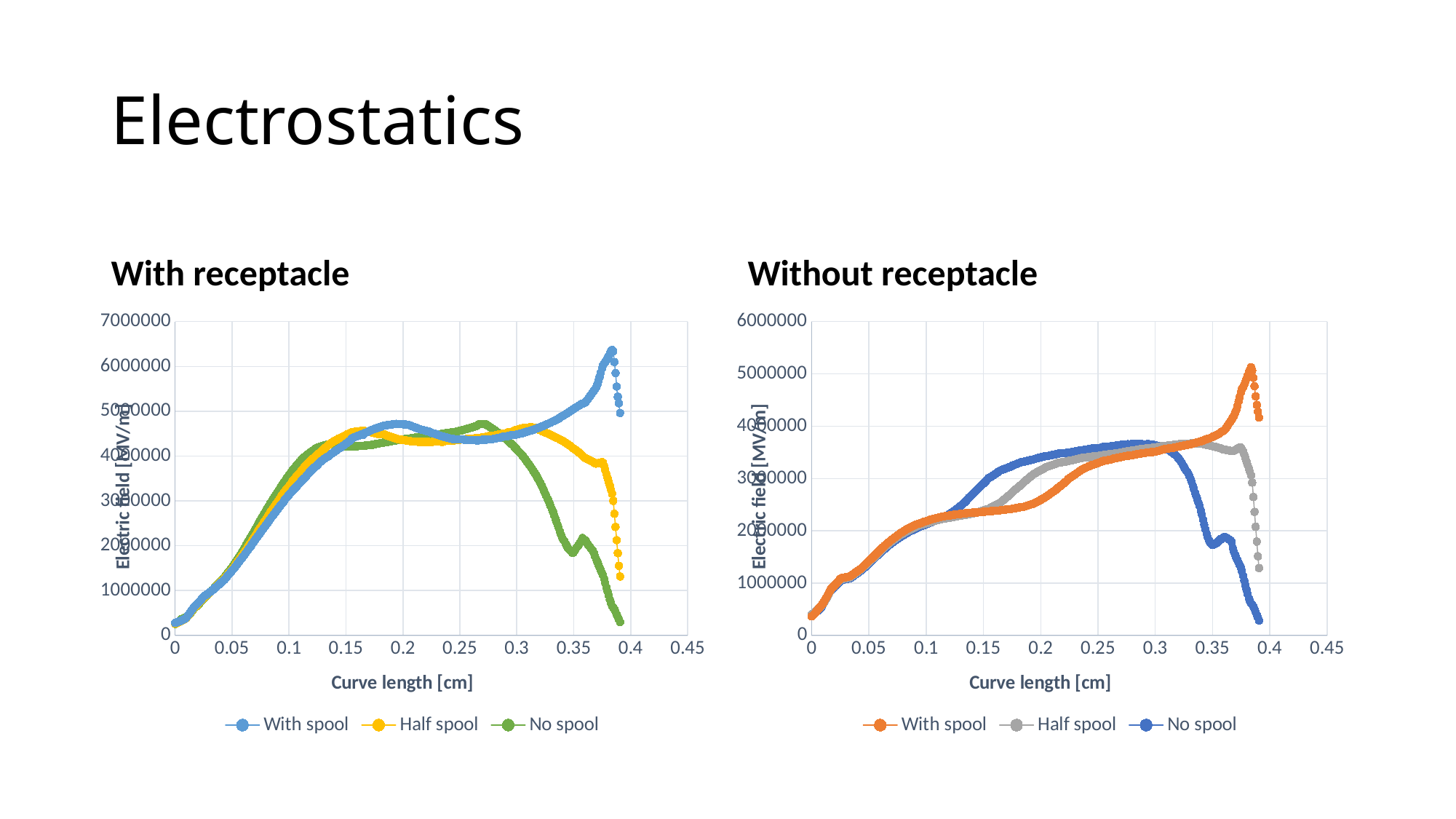
In the 'Without receptacle' chart, which series reaches the highest electric field value? With spool In the 'Without receptacle' chart, is the peak value of the With spool series greater or less than 4000000? greater In the 'With receptacle' chart, is the peak value of the With spool series greater or less than 5000000? greater How many series does the legend of the 'Without receptacle' chart list? 3 In the 'Without receptacle' chart, at a curve length of 0.35, which series has the higher value: Half spool or No spool? Half spool What is the x-axis title of the 'With receptacle' chart? Curve length [cm] In the 'With receptacle' chart, is the value of the Half spool series at a curve length of 0.3 greater or less than 4000000? greater What kind of chart is the 'With receptacle' chart? line chart In the 'With receptacle' chart, at a curve length of 0.35, which series has the higher value: Half spool or No spool? Half spool In the 'With receptacle' chart, which series reaches the highest electric field value? With spool In the 'Without receptacle' chart, does the No spool series rise or fall between curve lengths of 0.35 and 0.39? fall